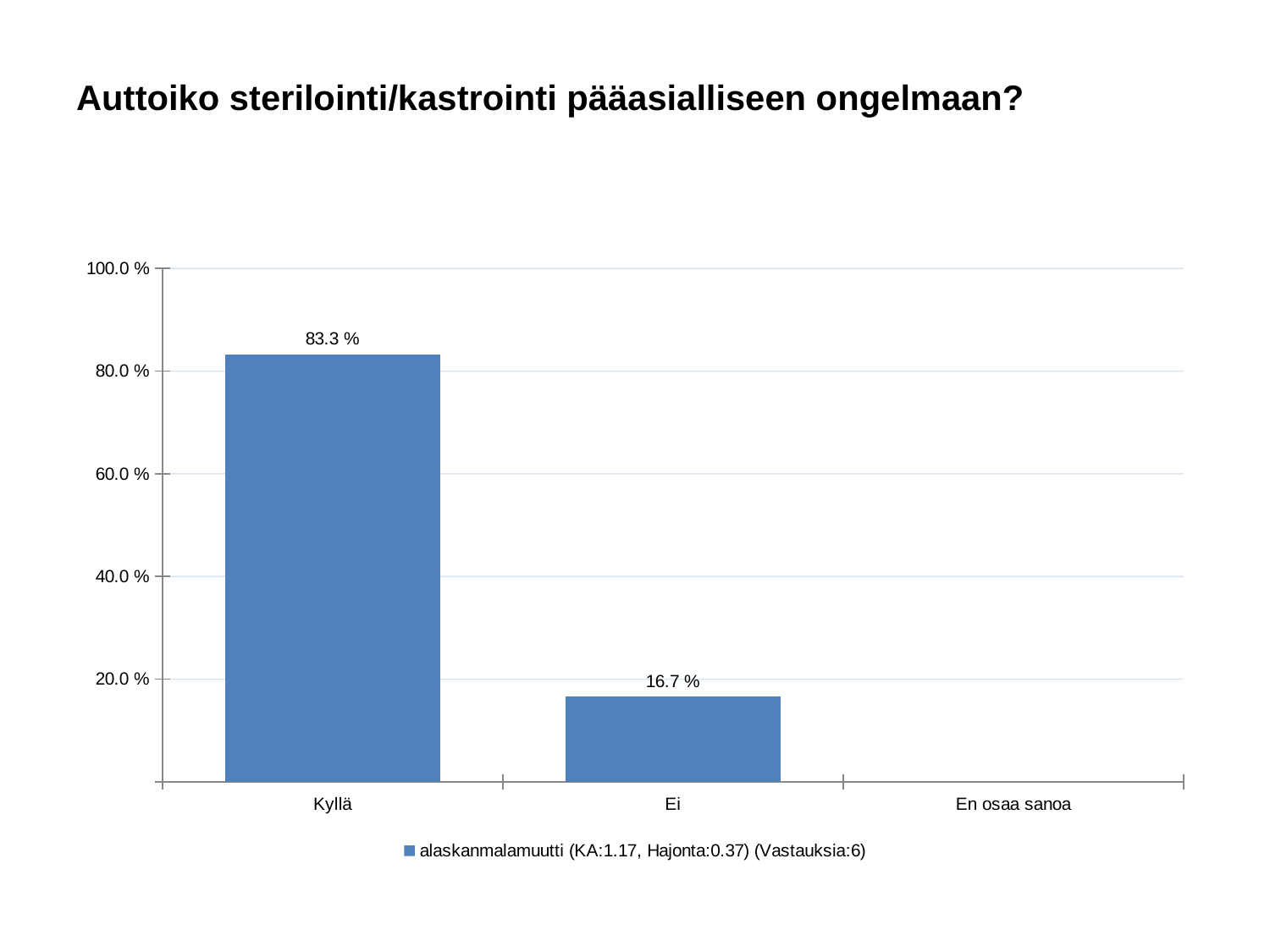
Which category has the highest value? Kyllä What is the value for Kyllä? 83.3 % What is the title of the chart? Auttoiko sterilointi/kastrointi pääasialliseen ongelmaan? What is the value for Ei? 16.7 % Which is larger, the value for Kyllä or the value for Ei? Kyllä How many series does the legend list? 1 What is the difference between the values for Kyllä and Ei? 66.6 % Is the value for Kyllä greater or less than 80.0 %? greater How many categories are shown on the x axis? 3 Is the value for Ei greater or less than 20.0 %? less What kind of chart is shown on the slide? bar chart Which category has the lowest value? En osaa sanoa